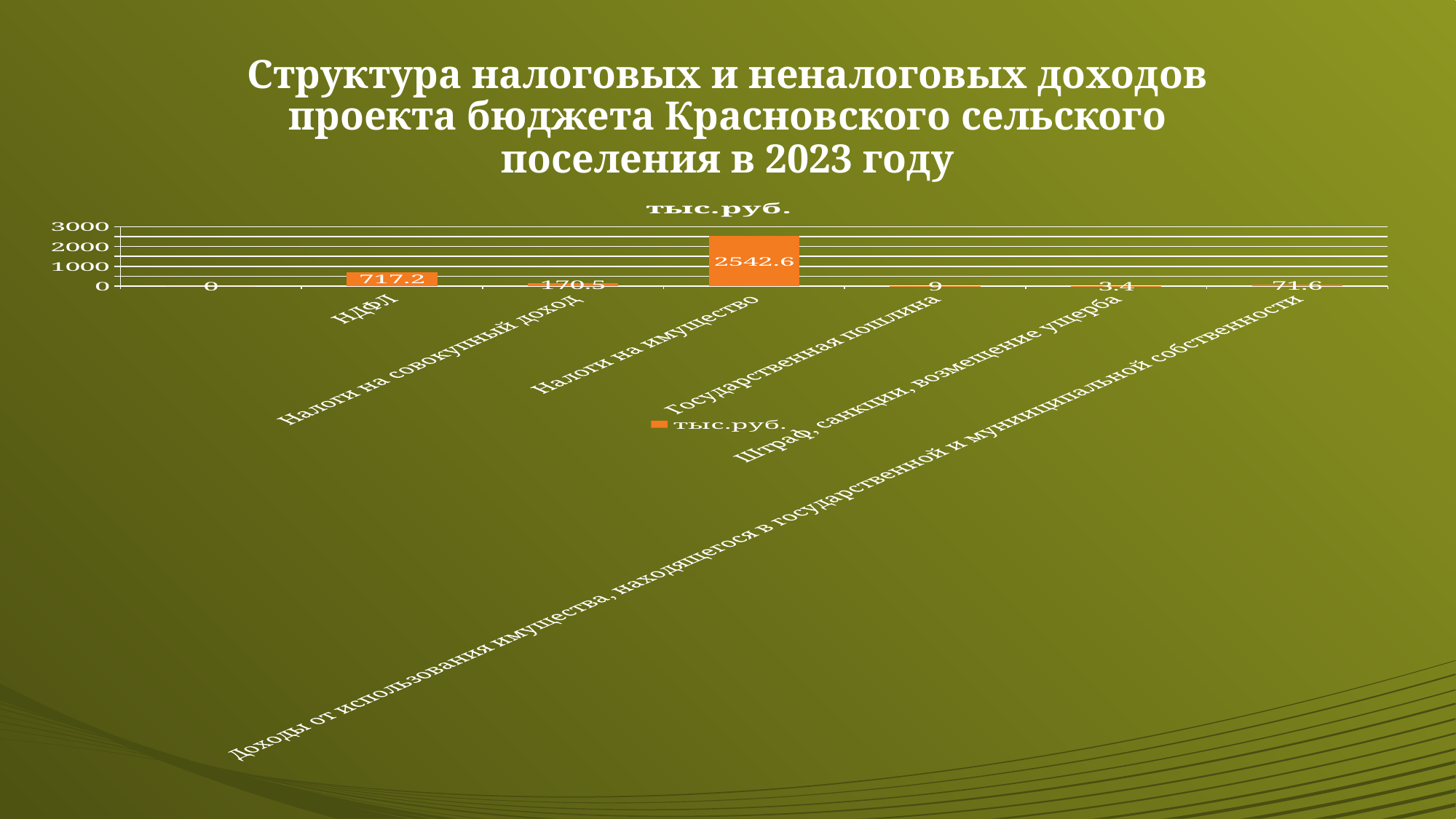
What is the value for НДФЛ? 717.2 Which labelled category has the lowest value? Штраф, санкции, возмещение ущерба Which labelled category has the highest value? Налоги на имущество Which is larger, the value for НДФЛ or the value for Налоги на совокупный доход? НДФЛ What kind of chart is shown on the slide? Bar chart What is the value for Государственная пошлина? 9 What is the difference between the values for Налоги на имущество and НДФЛ? 1825.4 What is the value for Штраф, санкции, возмещение ущерба? 3.4 What is the value for Доходы от использования имущества, находящегося в государственной и муниципальной собственности? 71.6 What is the value for Налоги на имущество? 2542.6 How many series does the legend list? 1 What is the value for Налоги на совокупный доход? 170.5